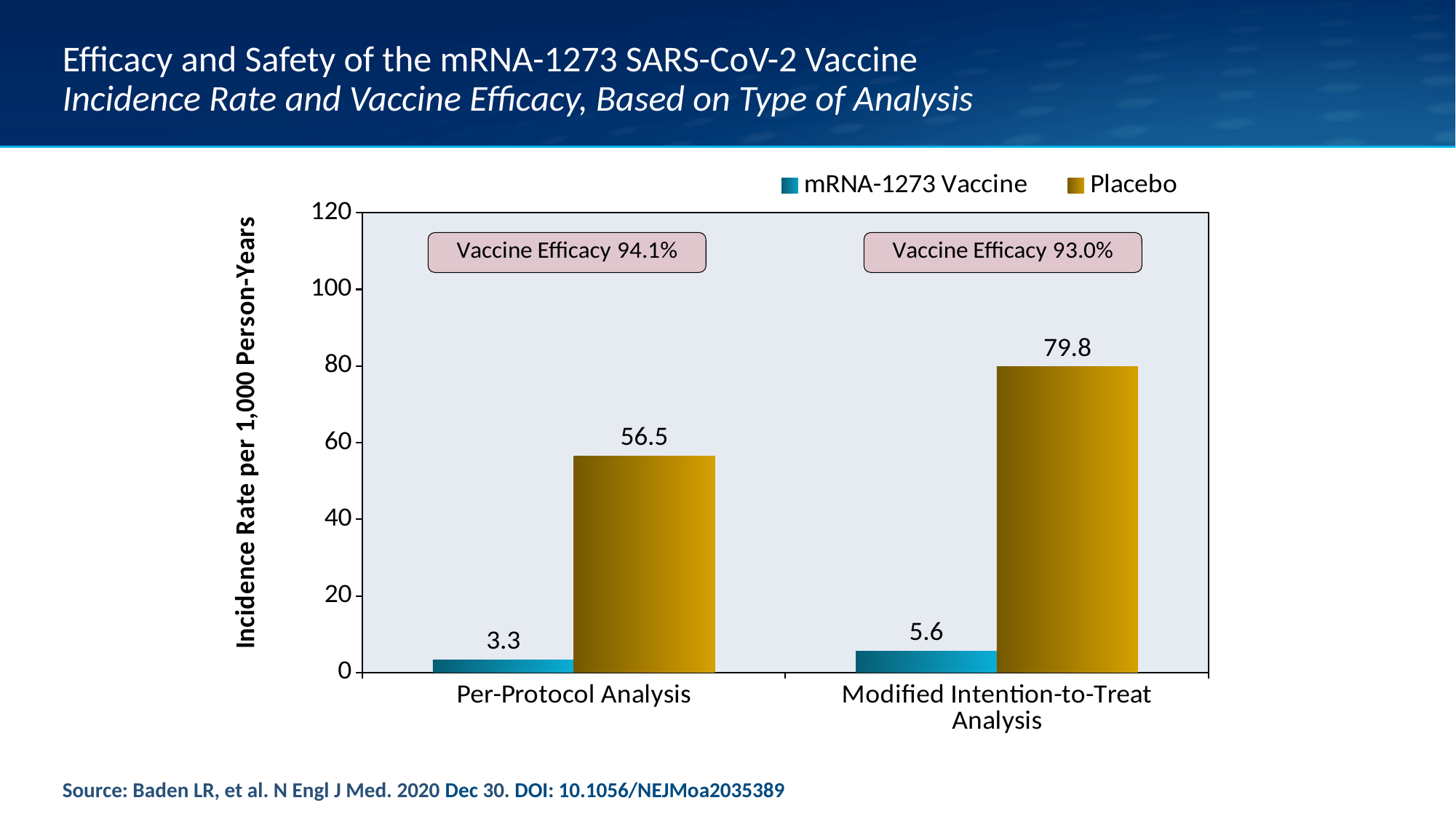
What vaccine efficacy is shown in the box above the Per-Protocol Analysis bars? 94.1% What is the incidence rate per 1,000 person-years for Placebo in the Modified Intention-to-Treat Analysis? 79.8 What kind of chart is shown on the slide? Bar chart What is the incidence rate per 1,000 person-years for the mRNA-1273 Vaccine in the Per-Protocol Analysis? 3.3 How many series does the legend list? 2 Which is larger: the mRNA-1273 Vaccine incidence rate in the Per-Protocol Analysis or in the Modified Intention-to-Treat Analysis? Modified Intention-to-Treat Analysis What is the incidence rate for the mRNA-1273 Vaccine in the Modified Intention-to-Treat Analysis? 5.6 Which bar has the lowest incidence rate on the chart? mRNA-1273 Vaccine, Per-Protocol Analysis What is the difference between the Placebo and mRNA-1273 Vaccine incidence rates in the Per-Protocol Analysis? 53.2 What is the difference between the Placebo incidence rates in the Modified Intention-to-Treat Analysis and the Per-Protocol Analysis? 23.3 What is the incidence rate for Placebo in the Per-Protocol Analysis? 56.5 Which bar has the highest incidence rate on the chart? Placebo, Modified Intention-to-Treat Analysis